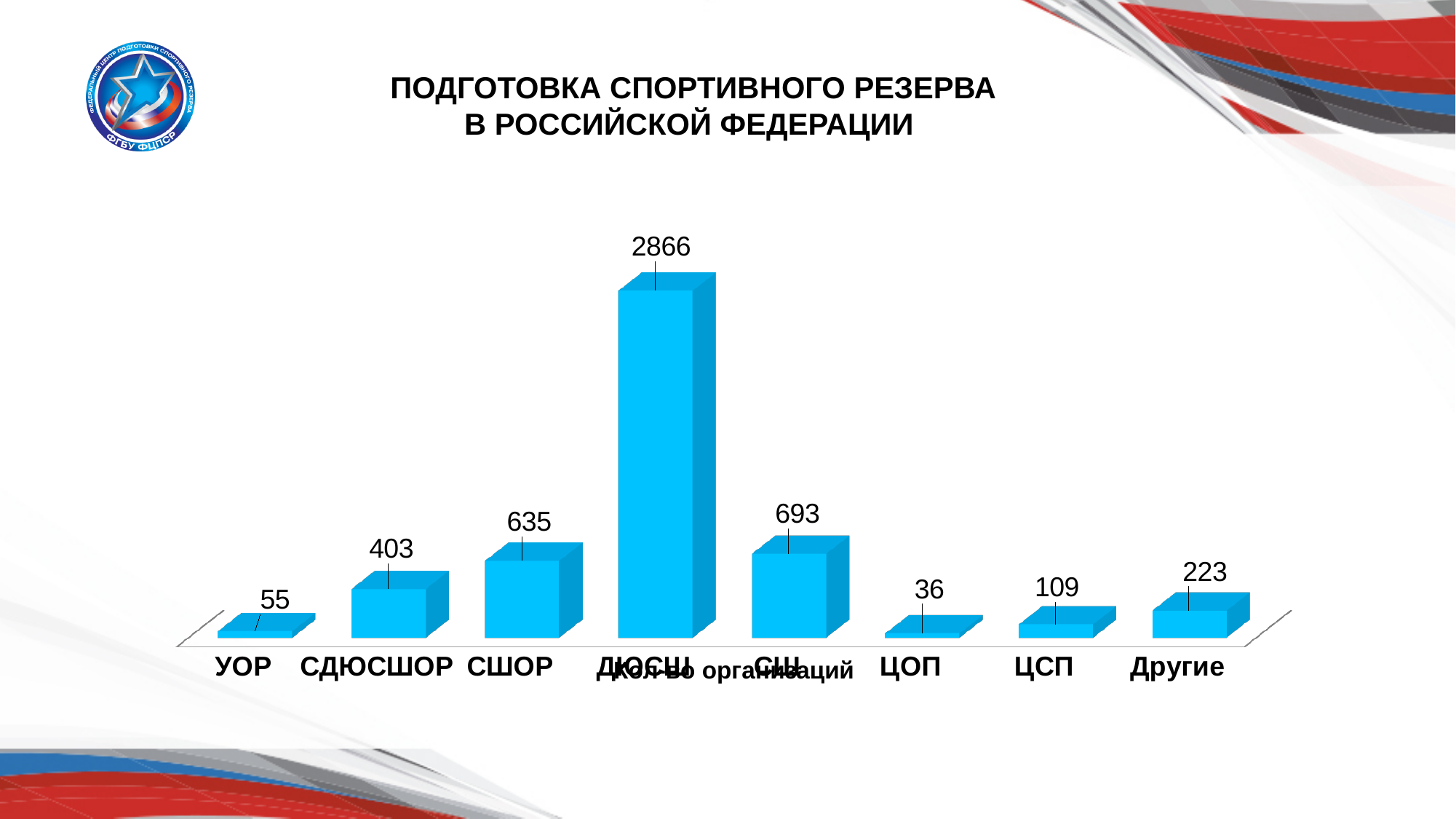
What is the difference between the values for Другие and ЦСП? 114 What is the value for ЦСП? 109 Which category has the highest value? ДЮСШ What is the value for ДЮСШ? 2866 What is the value for СДЮСШОР? 403 Which category has the lowest value? ЦОП What is the difference between the values for СШ and СШОР? 58 How many categories are shown on the x axis? 8 What kind of chart is shown on the slide? bar chart Which is larger, the value for СШОР or the value for СДЮСШОР? СШОР Which is larger, the value for УОР or the value for ЦОП? УОР What is the title of the slide? ПОДГОТОВКА СПОРТИВНОГО РЕЗЕРВА В РОССИЙСКОЙ ФЕДЕРАЦИИ